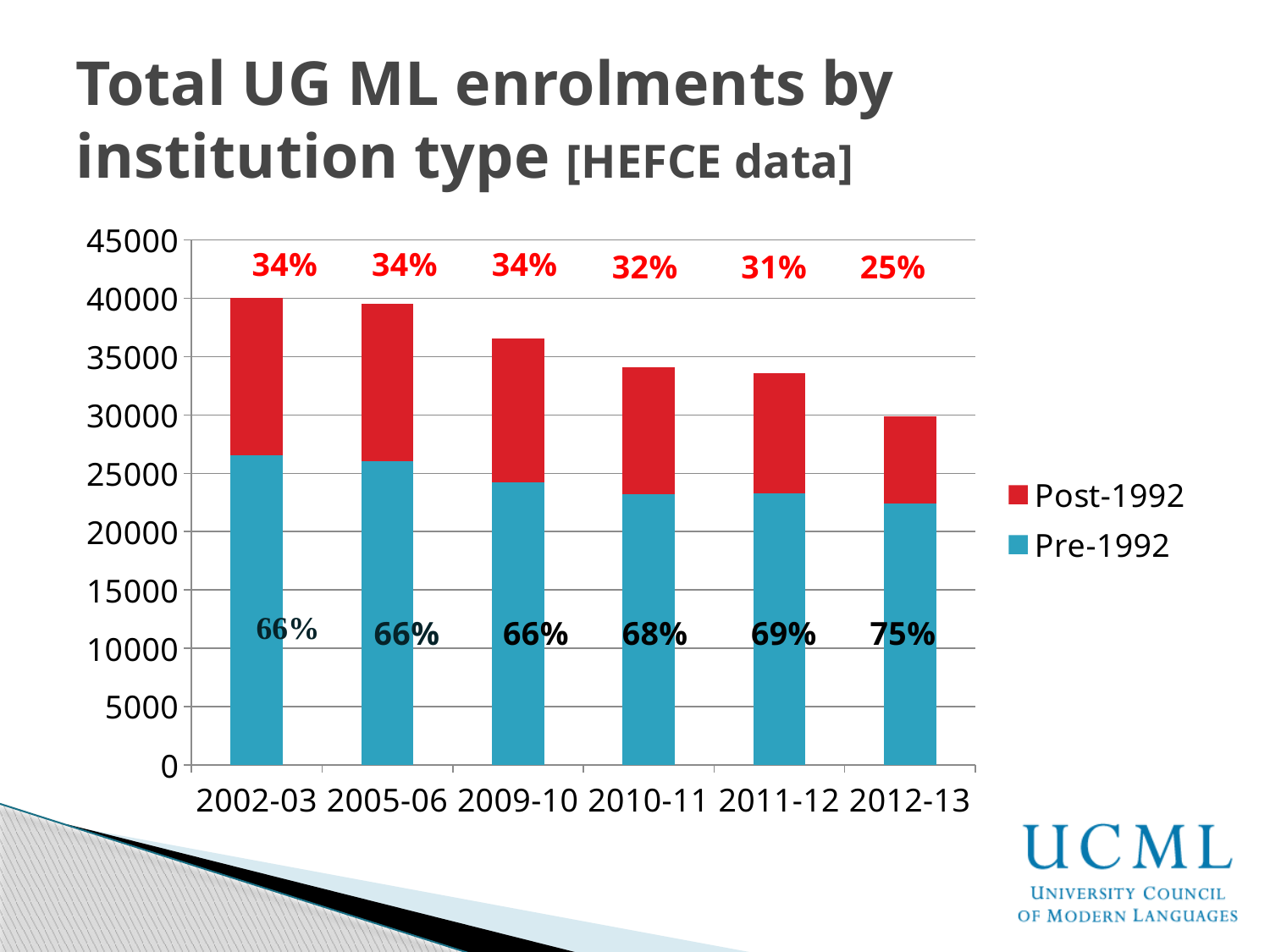
How many series does the legend list? 2 Do total enrolments rise or fall across the years from 2002-03 to 2012-13? fall Is the total enrolment for 2009-10 greater or less than 35000? greater What percentage label is shown for Post-1992 institutions in 2012-13? 25% How many academic years are shown on the x axis? 6 What percentage label is shown for Post-1992 institutions in 2010-11? 32% Which year has the lowest total enrolment bar? 2012-13 Which colour represents Post-1992 institutions in the legend? Red Is the Pre-1992 value for 2012-13 greater or less than 25000? less What percentage label is shown for Pre-1992 institutions in 2011-12? 69% Which year has the highest total enrolment bar? 2002-03 What kind of chart is shown on the slide? Stacked bar chart